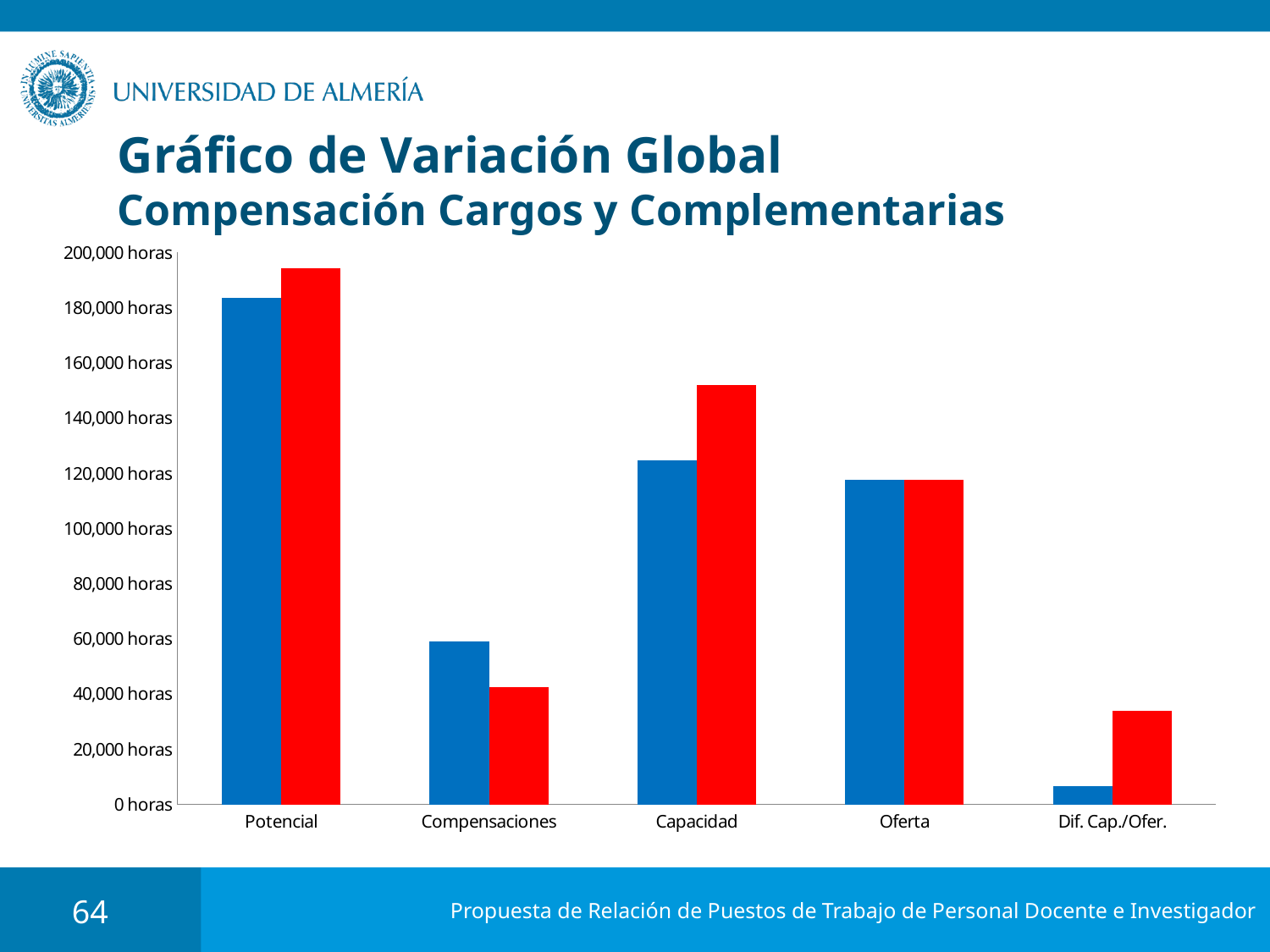
For Compensaciones, which bar is taller, the blue one or the red one? the blue one Is the red bar for Compensaciones greater or less than 60,000 horas? less Is the blue bar for Potencial greater or less than 160,000 horas? greater What kind of chart is shown on the slide? bar chart Which category has the shortest bars in the chart? Dif. Cap./Ofer. Which category has the tallest bars in the chart? Potencial Is the red bar for Capacidad greater or less than 140,000 horas? greater For Dif. Cap./Ofer., which bar is taller, the blue one or the red one? the red one What two colours are used for the bars in the chart? blue and red How many categories are shown on the x axis of the chart? 5 For Capacidad, which bar is taller, the blue one or the red one? the red one